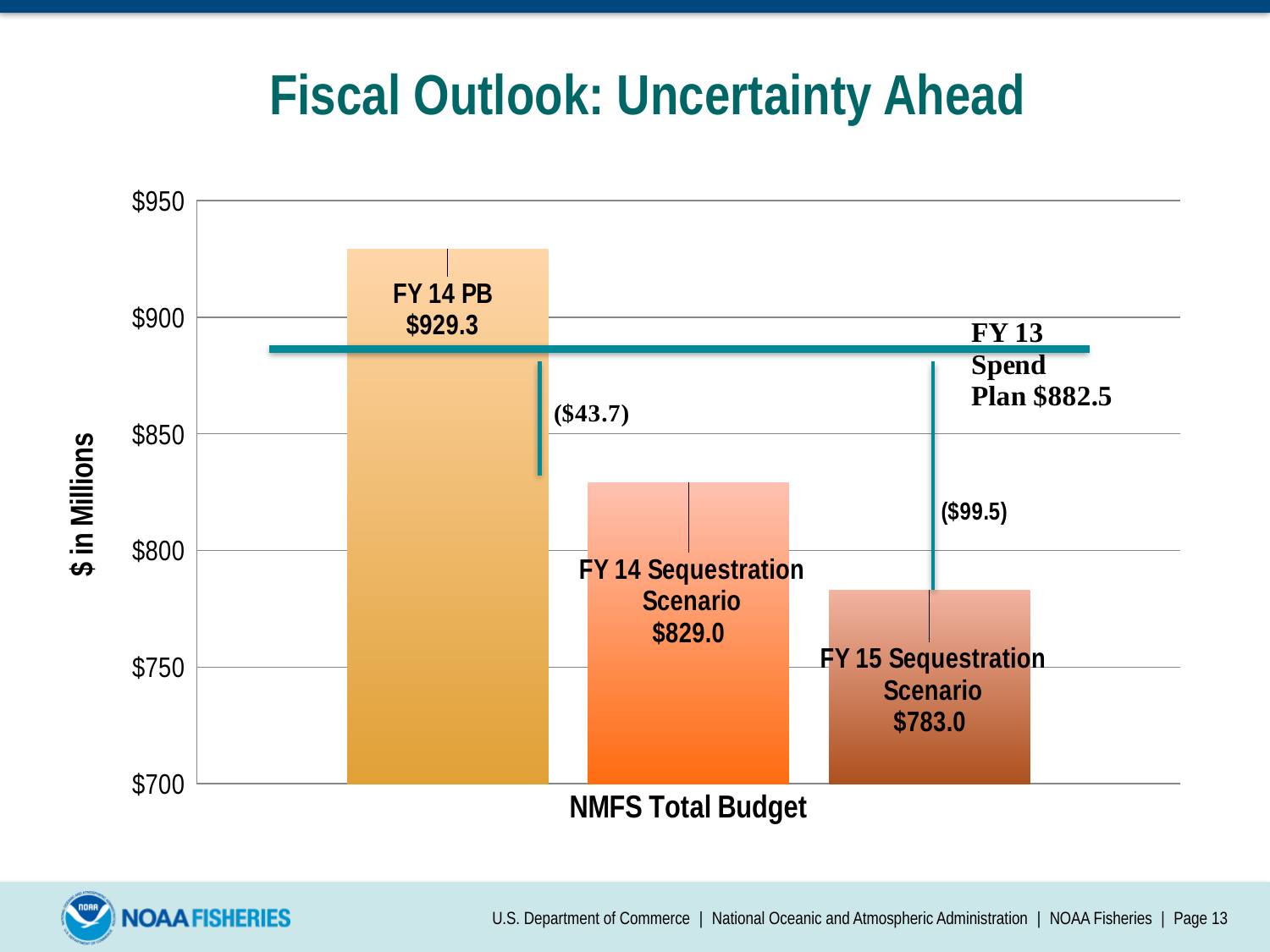
What is the value of the FY 14 Sequestration Scenario bar? $829.0 What kind of chart is shown on the slide? Bar chart What value is shown for the FY 13 Spend Plan line? $882.5 What is the difference between the FY 14 Sequestration Scenario bar and the FY 15 Sequestration Scenario bar? $46.0 What is the value of the FY 15 Sequestration Scenario bar? $783.0 How many bars are plotted in the chart? 3 What is the value of the FY 14 PB bar? $929.3 Which is larger, the FY 13 Spend Plan value or the FY 14 Sequestration Scenario value? FY 13 Spend Plan Which bar has the highest value? FY 14 PB What is the label on the vertical axis of the chart? $ in Millions Which bar has the lowest value? FY 15 Sequestration Scenario What is the difference between the FY 14 PB bar and the FY 14 Sequestration Scenario bar? $100.3